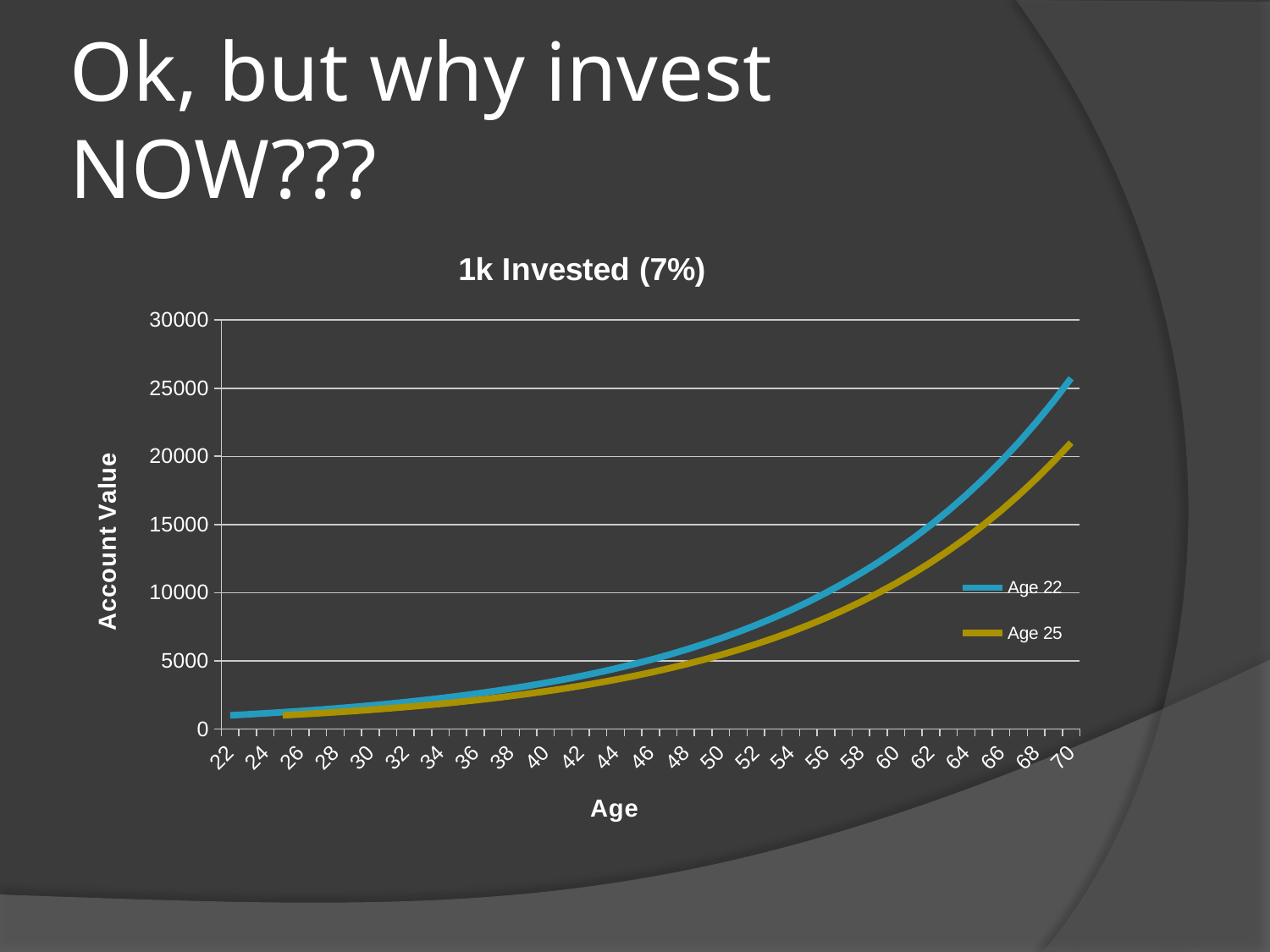
Is the value for the Age 25 series at age 60 greater or less than 15000? less Do the account values rise or fall as age increases along the x axis? rise Is the value for the Age 22 series at age 40 greater or less than 5000? less Is the value for the Age 25 series at age 70 greater or less than 25000? less At age 70, which series has the higher account value, Age 22 or Age 25? Age 22 Which series reaches the highest account value on the chart? Age 22 What kind of chart is shown on the slide? line chart What is the title of the chart? 1k Invested (7%) What is the label on the vertical axis? Account Value How many series does the legend list? 2